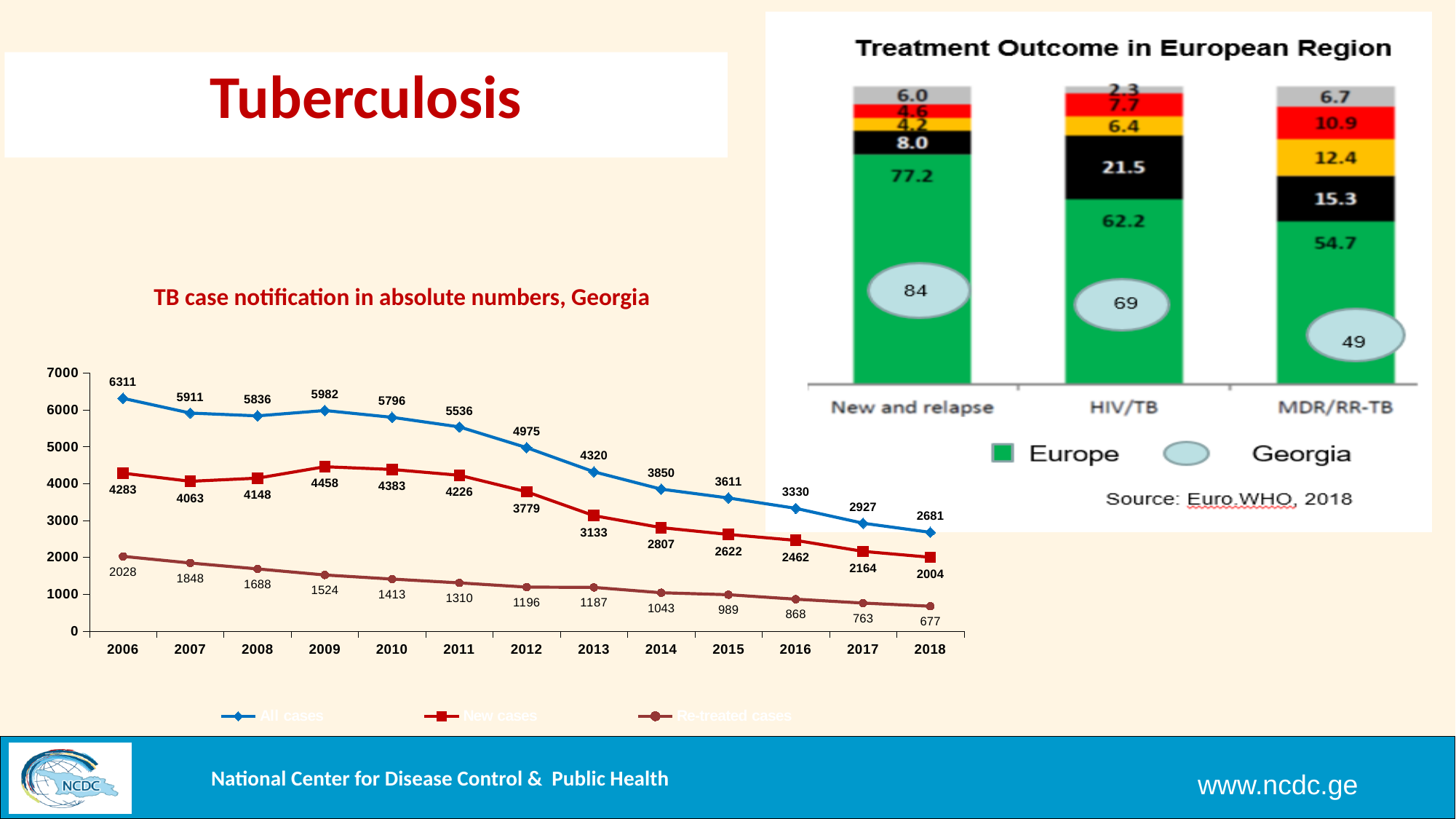
What kind of chart is 'Treatment Outcome in European Region'? stacked bar chart In the 'TB case notification in absolute numbers, Georgia' chart, what is the value for New cases in 2018? 2004 In the 'TB case notification in absolute numbers, Georgia' chart, what is the difference between All cases in 2006 and All cases in 2018? 3630 In the 'TB case notification in absolute numbers, Georgia' chart, do the values for All cases rise or fall from 2009 to 2018? fall In the 'TB case notification in absolute numbers, Georgia' chart, what is the value for Re-treated cases in 2012? 1196 In the 'TB case notification in absolute numbers, Georgia' chart, how many series does the legend list? 3 In the 'TB case notification in absolute numbers, Georgia' chart, which year has the highest value for New cases? 2009 In the 'TB case notification in absolute numbers, Georgia' chart, how many years are shown on the x axis? 13 In the 'TB case notification in absolute numbers, Georgia' chart, which year has the lowest value for All cases? 2018 In the 'TB case notification in absolute numbers, Georgia' chart, what is the value for All cases in 2006? 6311 In the 'Treatment Outcome in European Region' chart, what is the Georgia value shown for HIV/TB? 69 In the 'Treatment Outcome in European Region' chart, what is the green (Europe) value for the MDR/RR-TB bar? 54.7